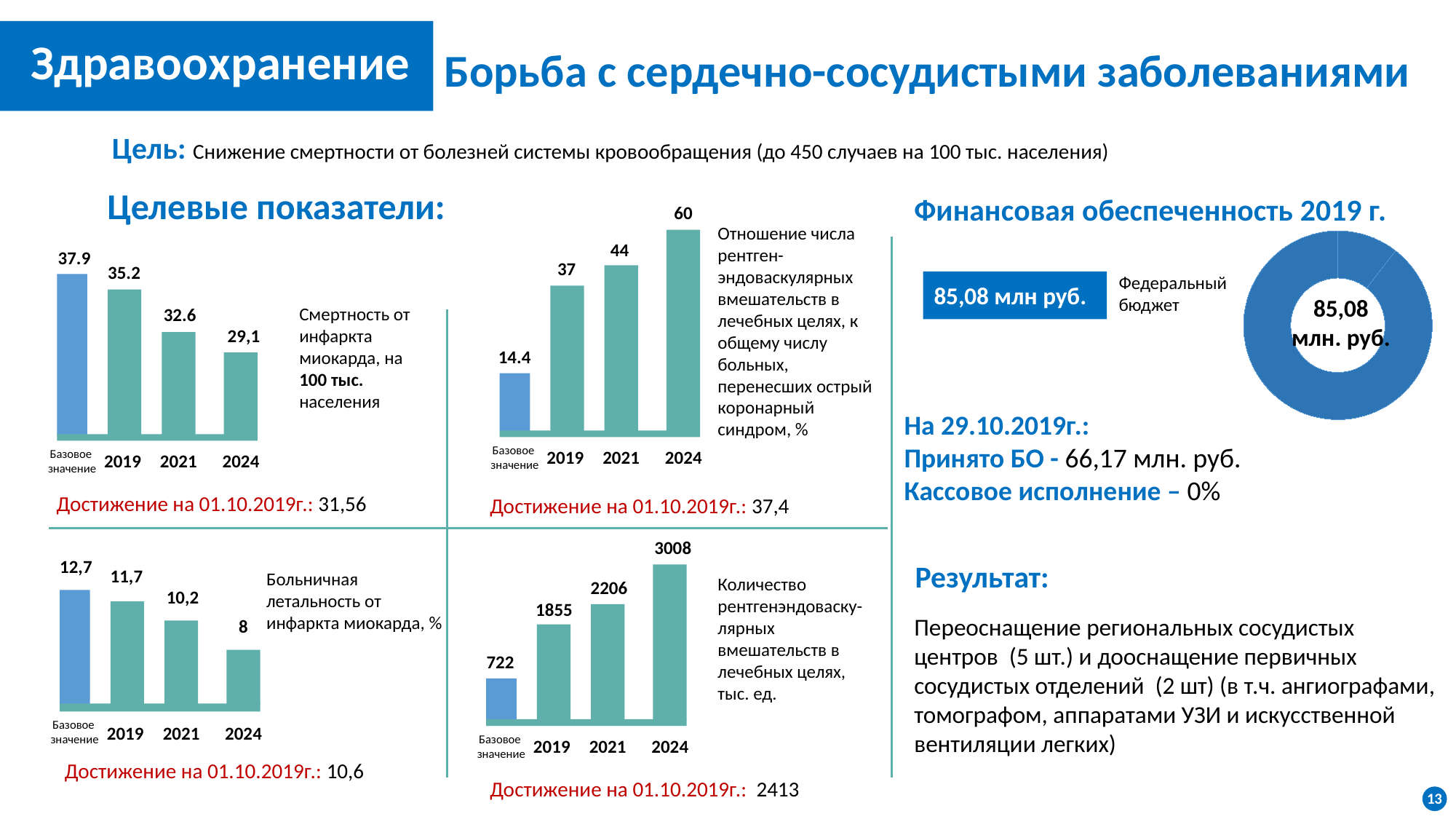
In the bottom-left chart (Больничная летальность от инфаркта миокарда), which is larger: the value for 2019 or for 2021? 2019 What kind of chart is shown under the heading Финансовая обеспеченность 2019 г.? Donut (pie) chart In the top-middle chart (Отношение числа рентген-эндоваскулярных вмешательств), which category has the lowest value? Базовое значение In the bottom-middle chart (Количество рентгенэндоваскулярных вмешательств), which category has the highest value? 2024 In the top-middle chart (Отношение числа рентген-эндоваскулярных вмешательств), what is the value for 2024? 60 In the top-left chart (Смертность от инфаркта миокарда), what is the базовое значение? 37.9 How many bars does the bottom-middle chart (Количество рентгенэндоваскулярных вмешательств) have? 4 In the top-left chart (Смертность от инфаркта миокарда), what is the value for 2021? 32.6 In the bottom-left chart (Больничная летальность от инфаркта миокарда), what is the value for 2024? 8 In the top-middle chart (Отношение числа рентген-эндоваскулярных вмешательств), what is the difference between the 2024 and 2019 values? 23 In the bottom-middle chart (Количество рентгенэндоваскулярных вмешательств), what is the value for 2021? 2206 In the top-left chart (Смертность от инфаркта миокарда), do the values rise or fall from the базовое значение to 2024? fall